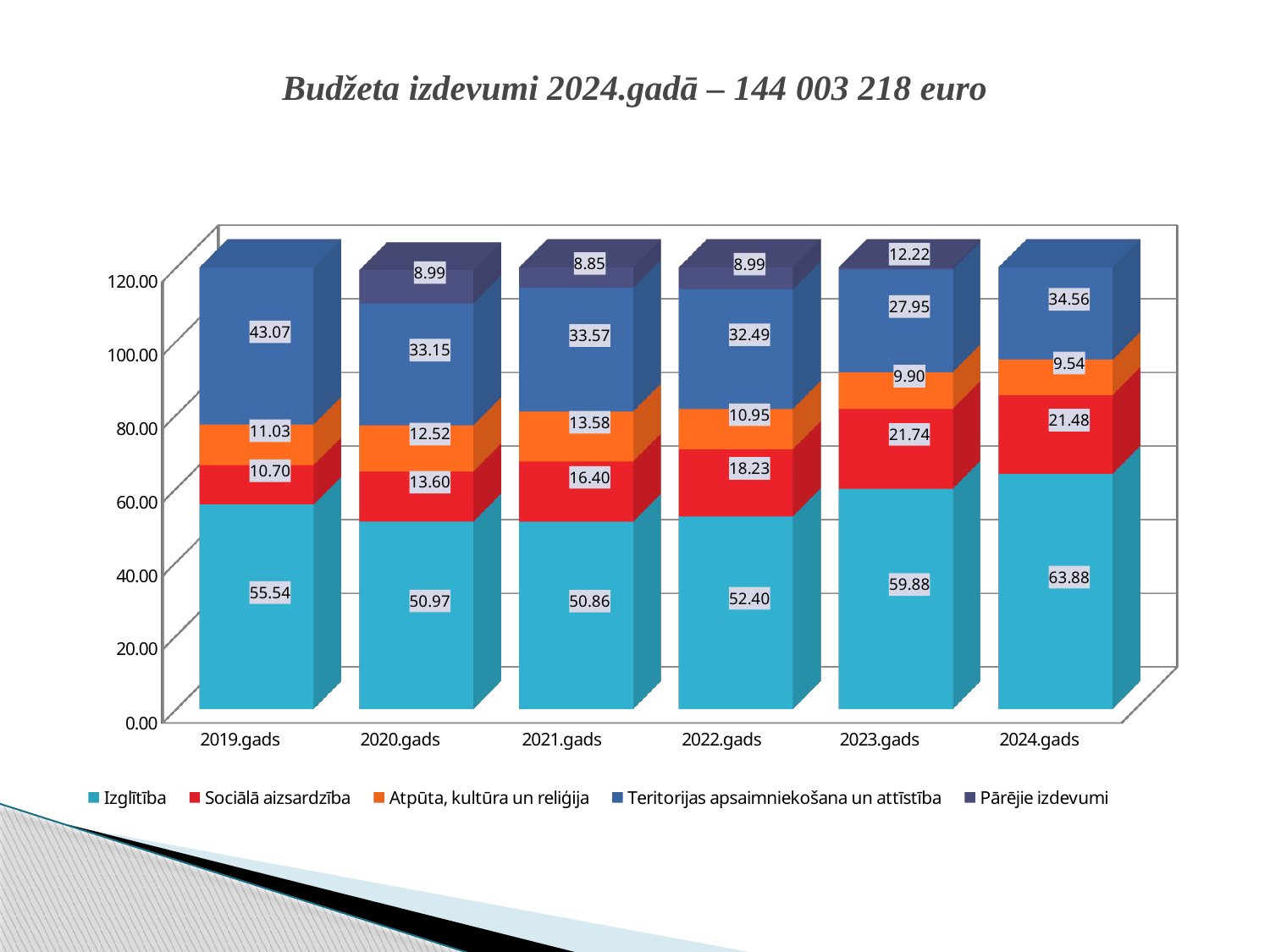
Which year has the larger Atpūta, kultūra un reliģija value, 2021.gads or 2022.gads? 2021.gads How many years are shown on the x axis? 6 What is the difference between the Sociālā aizsardzība values for 2024.gads and 2019.gads? 10.78 What is the value for Izglītība in 2024.gads? 63.88 What kind of chart is shown on the slide? Stacked bar chart How many series does the legend list? 5 What is the value for Teritorijas apsaimniekošana un attīstība in 2019.gads? 43.07 In which year is the Izglītība value highest? 2024.gads What is the total of the stacked bar for 2023.gads? 131.69 In which year is the Teritorijas apsaimniekošana un attīstība value lowest? 2023.gads What is the value for Pārējie izdevumi in 2023.gads? 12.22 Do the Sociālā aizsardzība values rise or fall from 2019.gads to 2024.gads? Rise